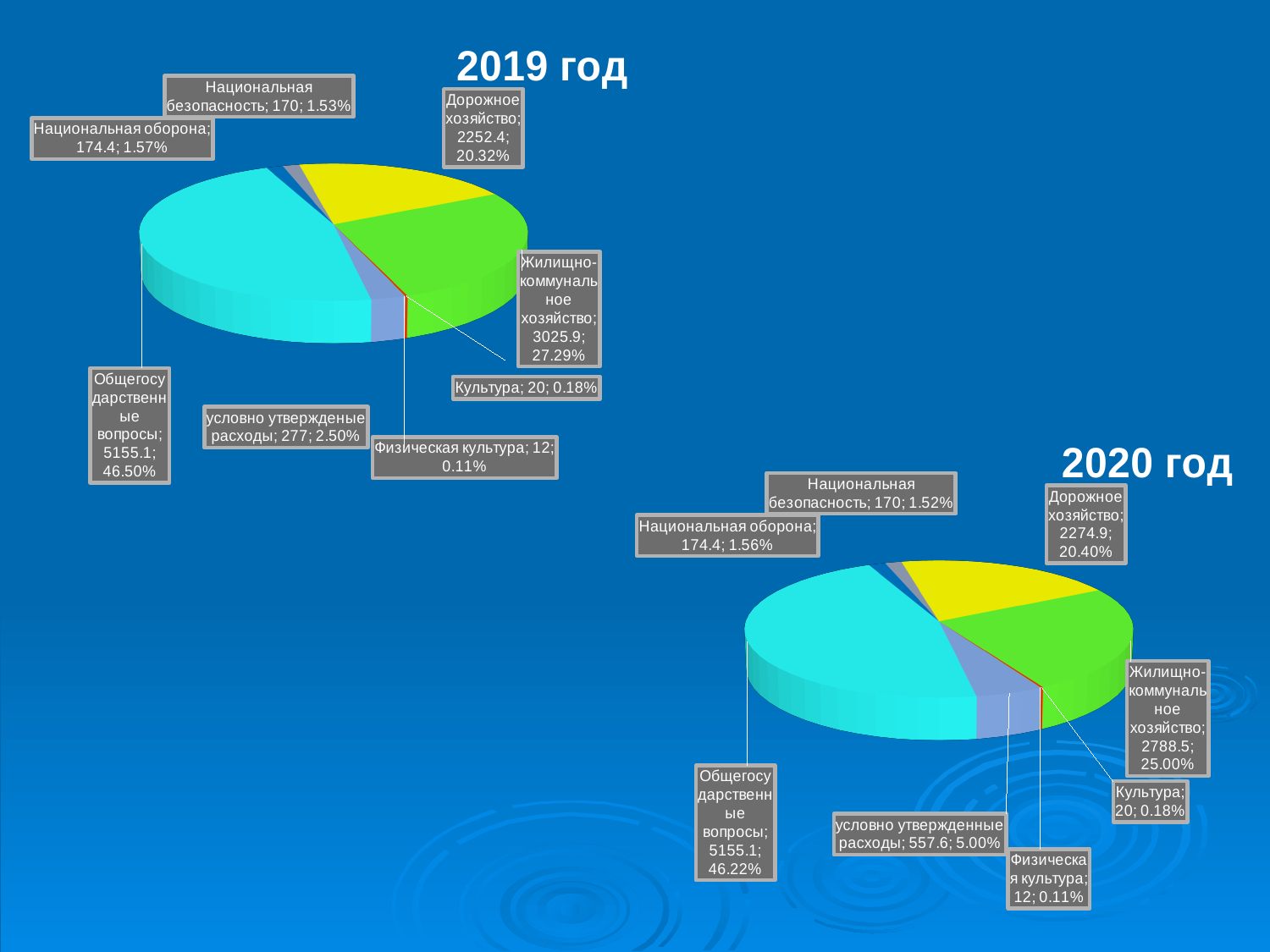
In the 2020 год chart, what value is shown for условно утвержденные расходы? 557.6 In the 2019 год chart, which category has the largest slice? Общегосударственные вопросы In the 2020 год chart, what share of the pie does Жилищно-коммунальное хозяйство have? 25.00% In the 2019 год chart, what share of the pie does Общегосударственные вопросы have? 46.50% What type of chart is used for 2019 год? Pie chart In the 2020 год chart, which category has the smallest slice? Физическая культура In the 2020 год chart, what percentage is shown for Культура? 0.18% What are the titles of the two charts on the slide? 2019 год and 2020 год In the 2019 год chart, what is the difference between the values for Жилищно-коммунальное хозяйство and Дорожное хозяйство? 773.5 In the 2019 год chart, what value is shown for Дорожное хозяйство? 2252.4 In the 2020 год chart, which is larger: the value for Национальная оборона or Национальная безопасность? Национальная оборона How many categories are shown in the 2020 год pie chart? 8